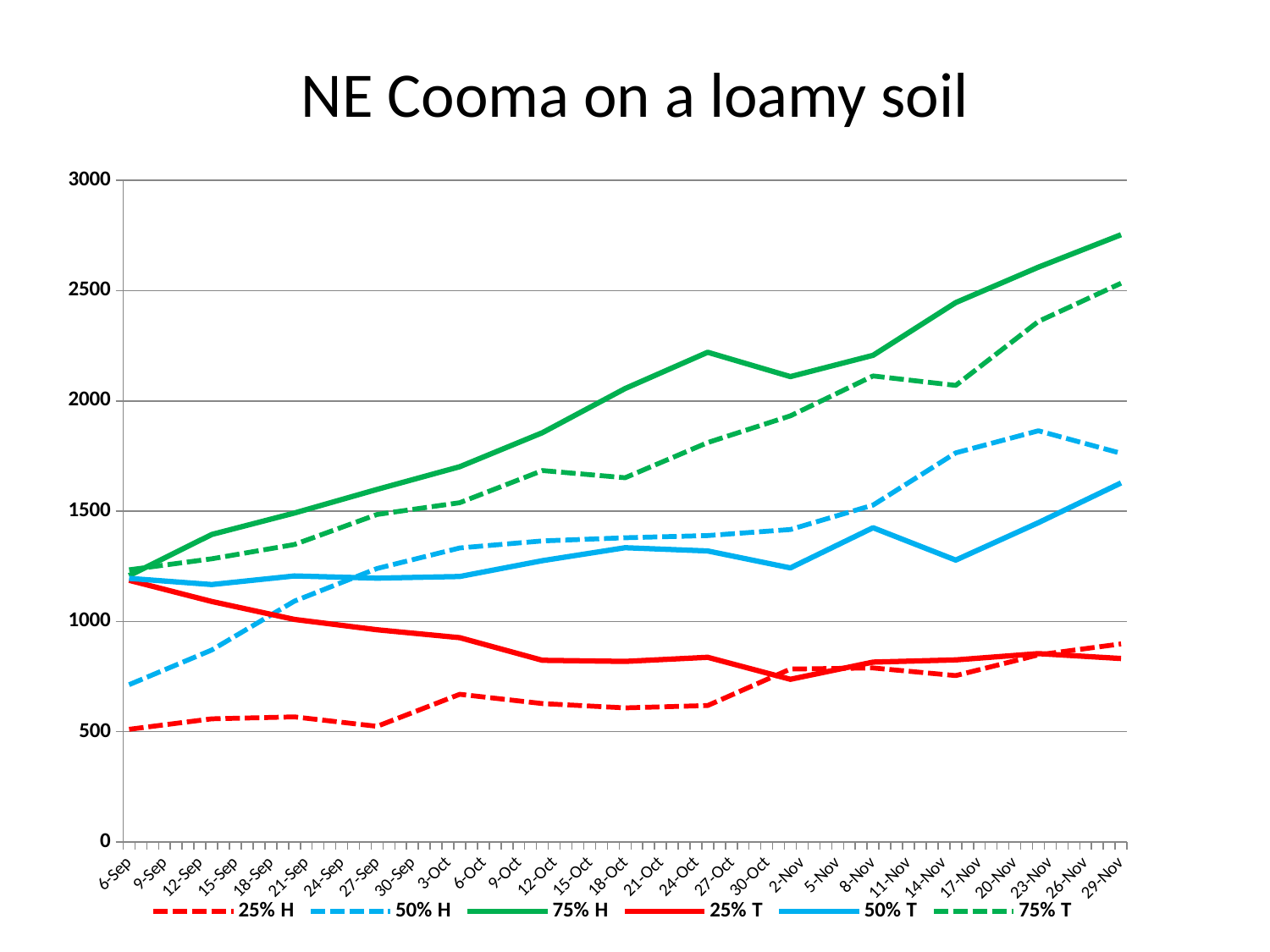
Which series has the highest value at 29-Nov? 75% H How many series does the legend list? 6 Does the 75% H series generally rise or fall from 6-Sep to 29-Nov? rise How many dates are labelled along the x axis? 29 Is the value for 75% H at 29-Nov greater or less than 2500? greater What kind of chart is shown on the slide? line chart Which series has the lowest value at 6-Sep? 25% H At 6-Sep, which is larger: 25% H or 25% T? 25% T Is the value for 25% H at 6-Sep greater or less than 1000? less Is the value for 50% T at 29-Nov greater or less than 1500? greater What is the title of the chart? NE Cooma on a loamy soil